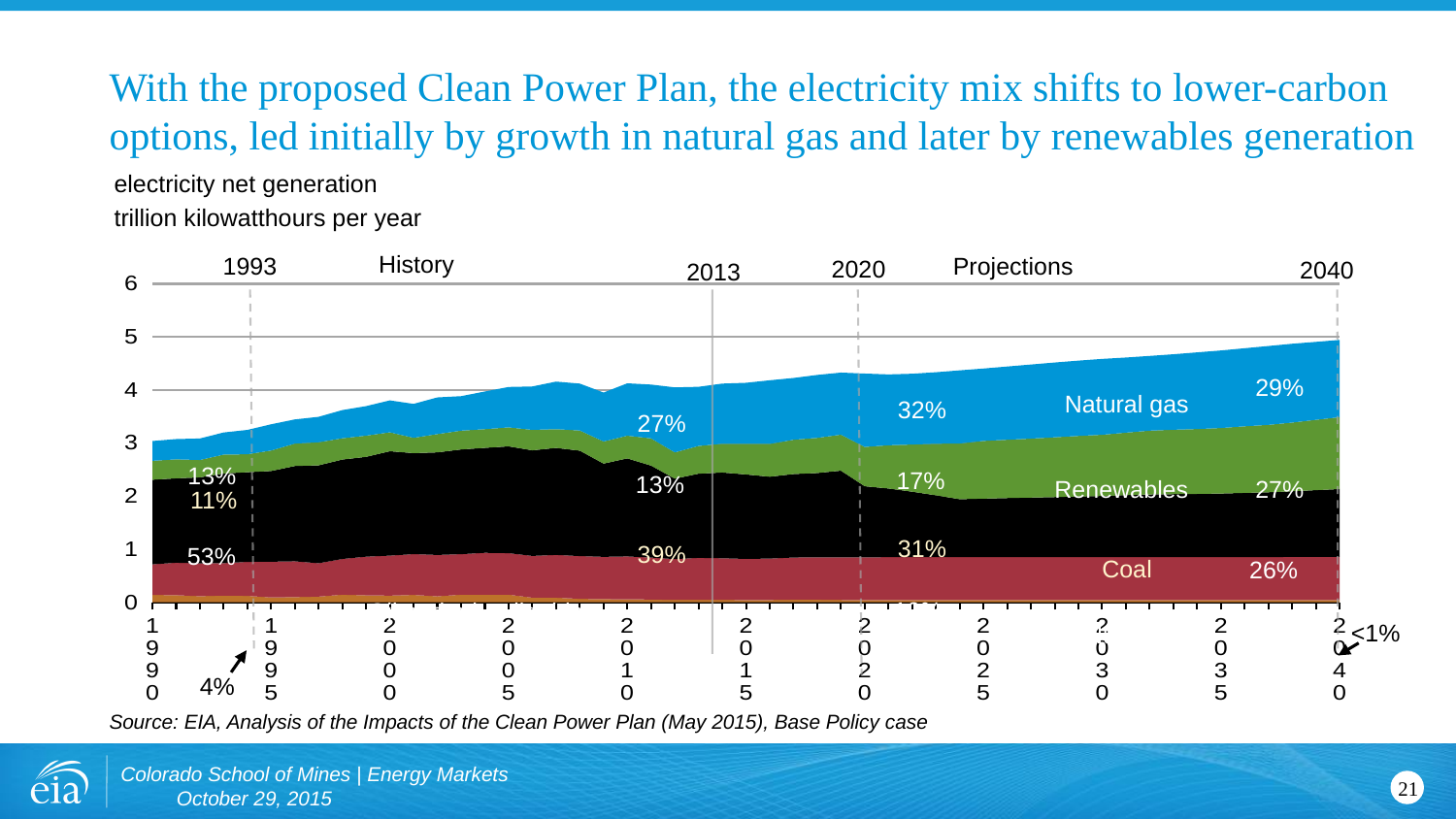
Does coal's share of generation rise or fall between 1993 and 2040? Fall What share of electricity net generation does coal have in 2040? 26% In 2040, which has the larger share of generation, natural gas or renewables? Natural gas What share of electricity net generation do renewables have in 2040? 27% By how many percentage points does coal's share fall from 1993 (53%) to 2040 (26%)? 27 percentage points What unit is used on the chart's y axis? trillion kilowatthours per year What share of electricity net generation does natural gas have in 2040? 29% What share of electricity net generation did natural gas have in 2013? 27% Is total electricity net generation in 2040 greater or less than 4 trillion kilowatthours? greater What kind of chart is shown on the slide? Stacked area chart What share of electricity net generation did coal have in 1993? 53% What share of electricity net generation does natural gas have in 2020? 32%